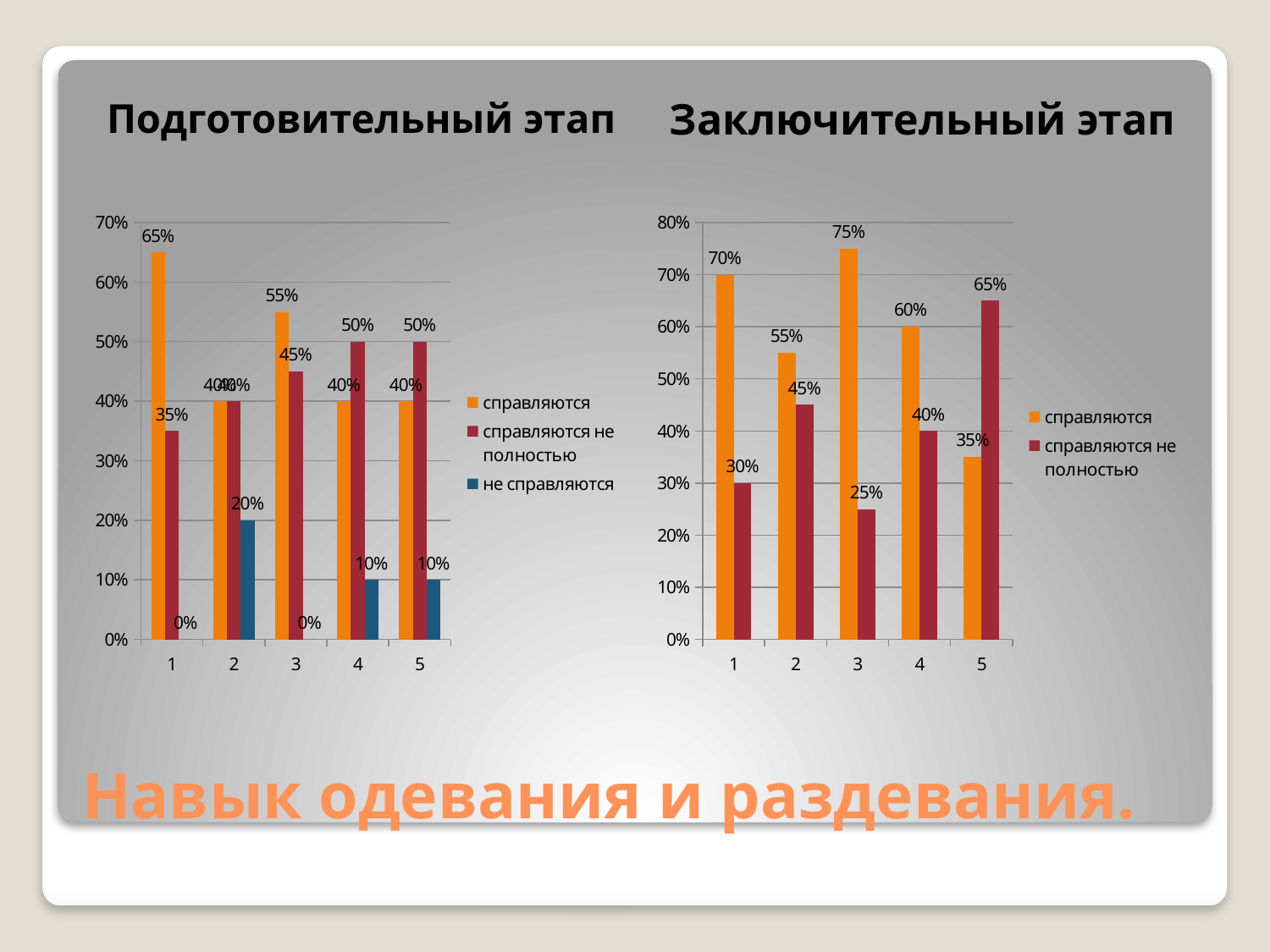
In the 'Подготовительный этап' chart, how many series does the legend list? 3 In the 'Заключительный этап' chart, which category has the lowest value for 'справляются'? 5 In the 'Заключительный этап' chart, what is the value of 'справляются' for category 3? 75% In the 'Подготовительный этап' chart, what is the difference between 'справляются не полностью' and 'справляются' for category 4? 10% How many categories are shown on the x axis of the 'Заключительный этап' chart? 5 What type of chart is the 'Подготовительный этап' chart? bar chart In the 'Подготовительный этап' chart, what is the value of 'справляются' for category 1? 65% In the 'Заключительный этап' chart, which is larger for category 2: 'справляются' or 'справляются не полностью'? справляются In the 'Заключительный этап' chart, what is the difference between 'справляются' and 'справляются не полностью' for category 1? 40% In the 'Заключительный этап' chart, what is the value of 'справляются не полностью' for category 5? 65% In the 'Подготовительный этап' chart, which category has the highest value for 'справляются'? 1 In the 'Подготовительный этап' chart, what is the value of 'не справляются' for category 2? 20%